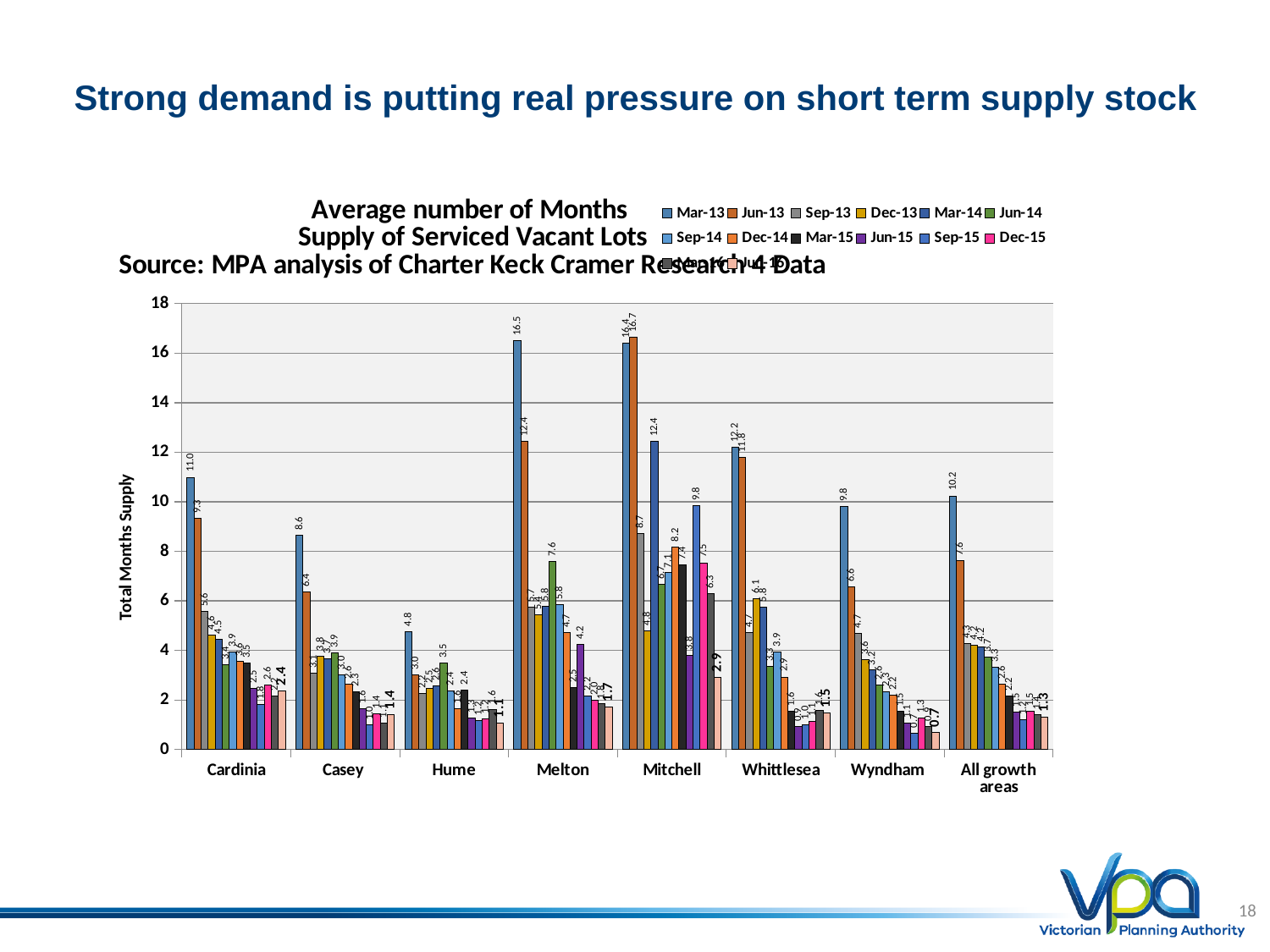
Is the Mar-13 value for Wyndham greater or less than 8? greater What is the difference between the Mar-13 values for Cardinia and Casey? 2.4 What is the difference between the Jun-13 and Mar-13 values for Mitchell? 0.3 What is the title of the y axis? Total Months Supply What is the Mar-13 value for Cardinia? 11.0 What kind of chart is shown on the slide? bar chart Which is larger, the Mar-13 value for Whittlesea or the Mar-13 value for Wyndham? Whittlesea Which category has the lowest Mar-13 value? Hume How many growth-area categories are shown along the x axis? 8 What is the Jun-13 value for Wyndham? 6.6 What is the Mar-13 value for Melton? 16.5 Which category has the highest Jun-13 value? Mitchell